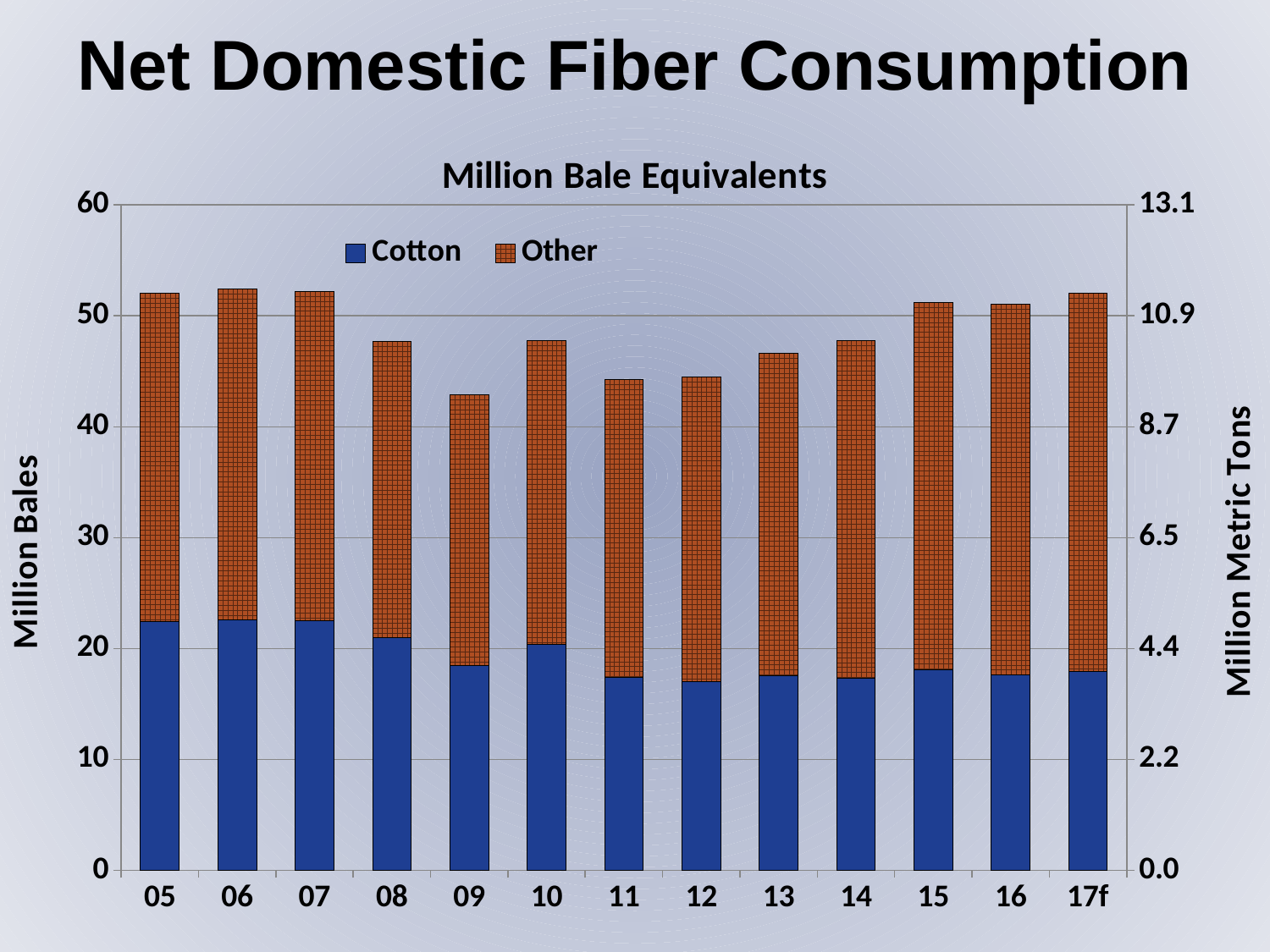
What is the label of the left vertical axis? Million Bales Which year has the larger total bar, 09 or 10? 10 Is the Cotton value for 12 greater or less than 20 million bales? less What kind of chart is shown on the slide? Stacked bar chart Is the total bar for 05 greater or less than 50 million bales? greater Does total fiber consumption rise or fall from 07 to 09? Fall Is the total bar for 09 greater or less than 50 million bales? less How many series does the legend list? 2 Which year has the lowest total fiber consumption? 09 What is the label of the right vertical axis? Million Metric Tons How many years (categories) are shown on the x axis? 13